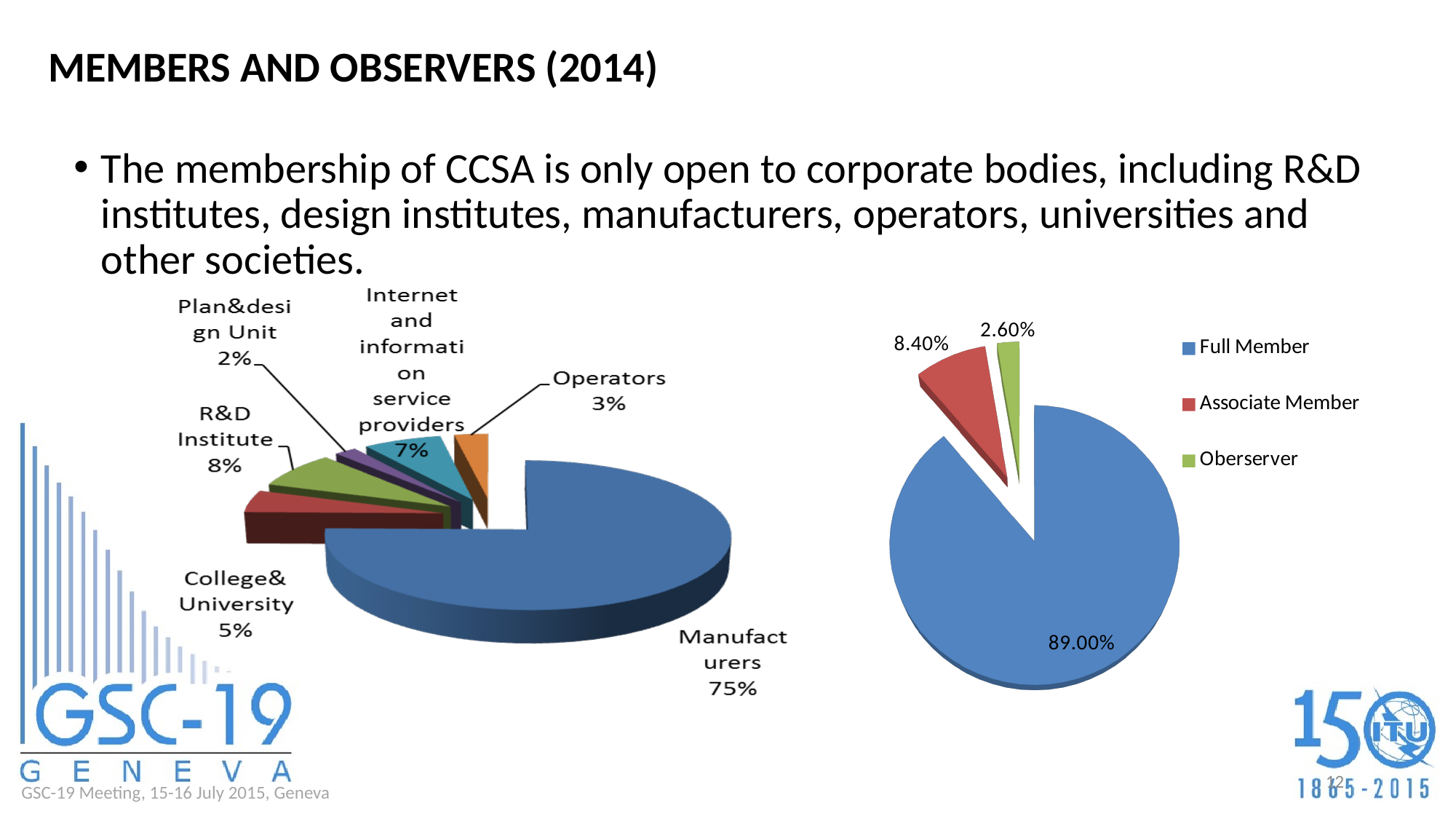
In the right pie chart, what share do Associate Members have? 8.40% What kind of chart is the right chart? Pie chart In the left pie chart, how many slices are there? 6 In the left pie chart, which category has the smallest share? Plan&design Unit In the left pie chart, what is the difference between the shares of College&University and Operators? 2% In the left pie chart, what share do Internet and information service providers have? 7% In the left pie chart, what share does the R&D Institute slice have? 8% In the left pie chart, what share do Manufacturers have? 75% In the right pie chart, which category has the smallest share? Oberserver In the left pie chart, which category has the largest share? Manufacturers How many entries does the legend of the right pie chart list? 3 In the right pie chart, what share do Full Members have? 89.00%